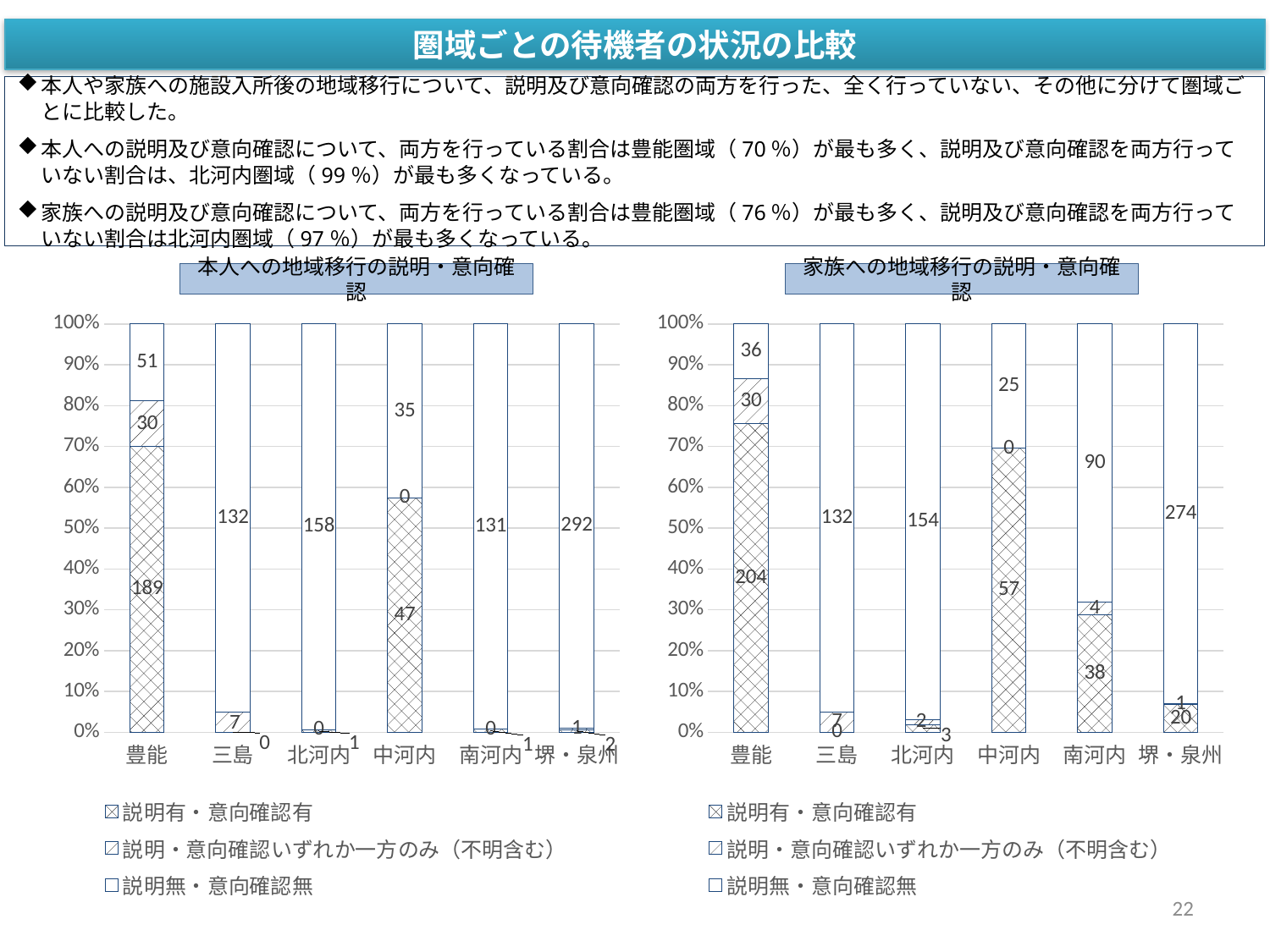
In the left chart (本人への地域移行の説明・意向確認), what is the value of 説明有・意向確認有 for 豊能? 189 In the right chart (家族への地域移行の説明・意向確認), what is the total of the stacked bar for 豊能? 270 What kind of chart is the left chart (本人への地域移行の説明・意向確認)? Stacked bar chart In the left chart (本人への地域移行の説明・意向確認), what is the total of the stacked bar for 豊能? 270 In the right chart (家族への地域移行の説明・意向確認), which region has the highest value of 説明無・意向確認無? 堺・泉州 In the left chart (本人への地域移行の説明・意向確認), which is larger: the 説明無・意向確認無 value for 三島 or for 北河内? 北河内 How many series does the legend of the right chart (家族への地域移行の説明・意向確認) list? 3 In the right chart (家族への地域移行の説明・意向確認), what is the value of 説明有・意向確認有 for 南河内? 38 How many regions are shown on the x axis of the left chart (本人への地域移行の説明・意向確認)? 6 In the left chart (本人への地域移行の説明・意向確認), what is the value of 説明無・意向確認無 for 中河内? 35 In the left chart (本人への地域移行の説明・意向確認), what is the value of 説明無・意向確認無 for 堺・泉州? 292 In the right chart (家族への地域移行の説明・意向確認), what is the value of 説明無・意向確認無 for 北河内? 154